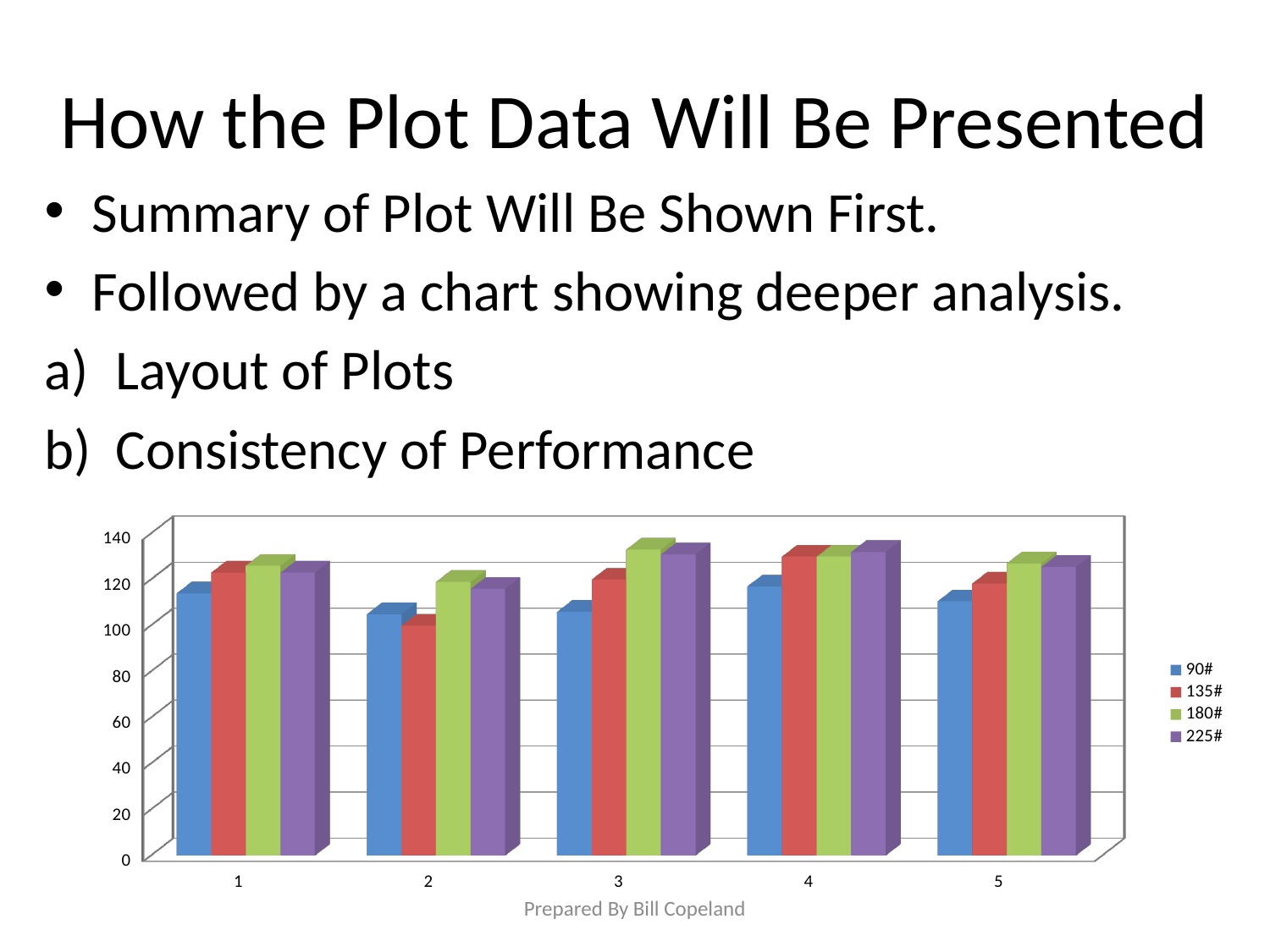
How many categories are shown along the x axis of the chart? 5 What are the series names listed in the chart's legend? 90#, 135#, 180#, 225# How many series does the chart's legend list? 4 What colour are the bars for the 90# series? blue Is the value for 90# at category 1 greater or less than 100? greater What kind of chart is shown on the slide? bar chart At category 4, which is larger: the 90# bar or the 135# bar? 135# At category 3, which series has the lowest bar? 90# Is the value for 180# at category 3 greater or less than 120? greater Is the value for 90# at category 2 greater or less than 120? less At category 2, which is larger: the 90# bar or the 180# bar? 180#